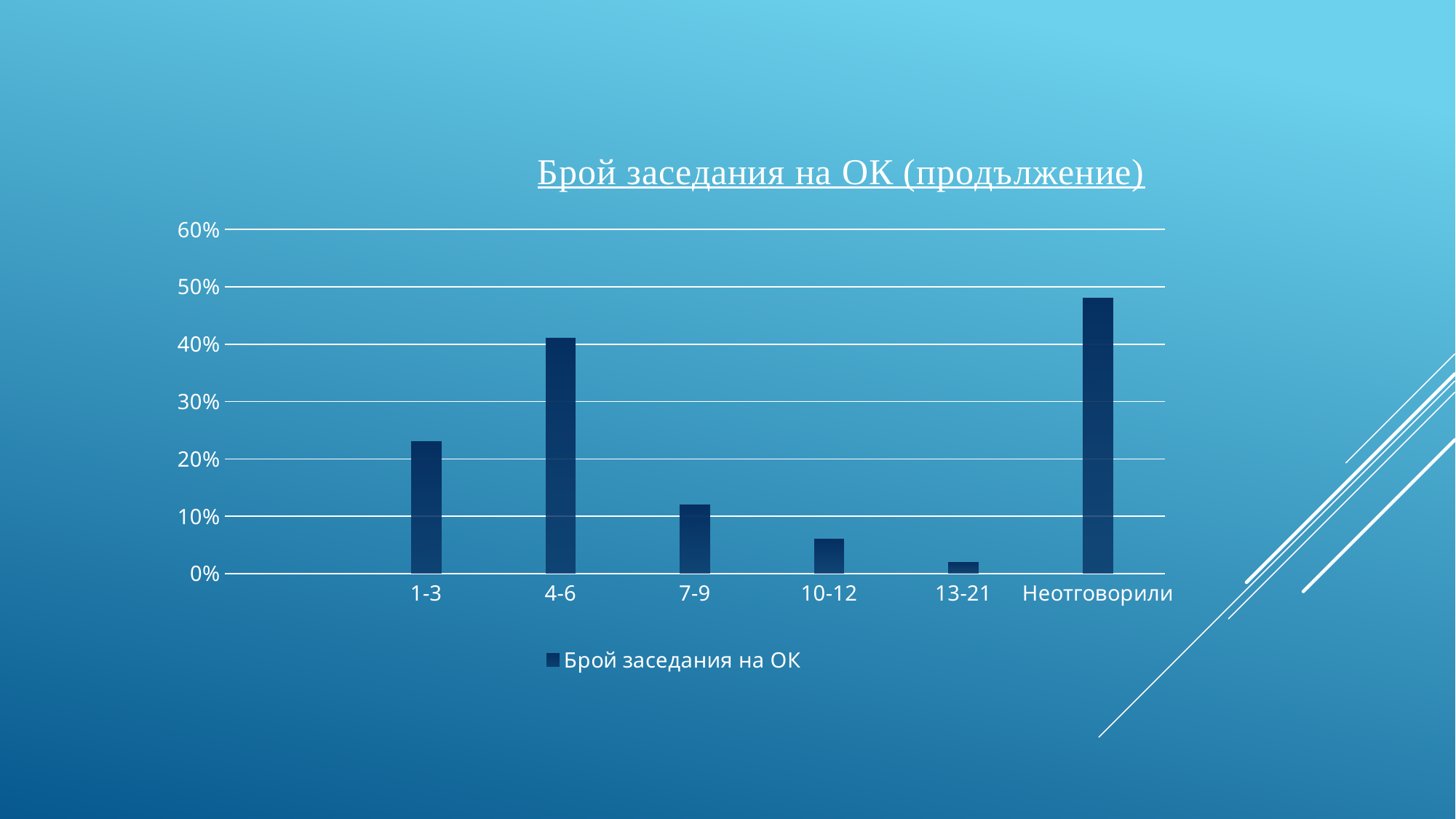
How many categories are shown on the x axis of the chart? 6 Which category has the highest bar? Неотговорили Is the value for Неотговорили greater or less than 50%? less Which category has the lowest bar? 13-21 What is the title of the chart? Брой заседания на ОК (продължение) Is the value for 1-3 greater or less than 20%? greater What kind of chart is shown on the slide? bar chart How many series does the legend list? 1 Which is larger, the value for 1-3 or the value for 7-9? 1-3 What is the name of the series shown in the legend? Брой заседания на ОК Is the value for 10-12 greater or less than 10%? less